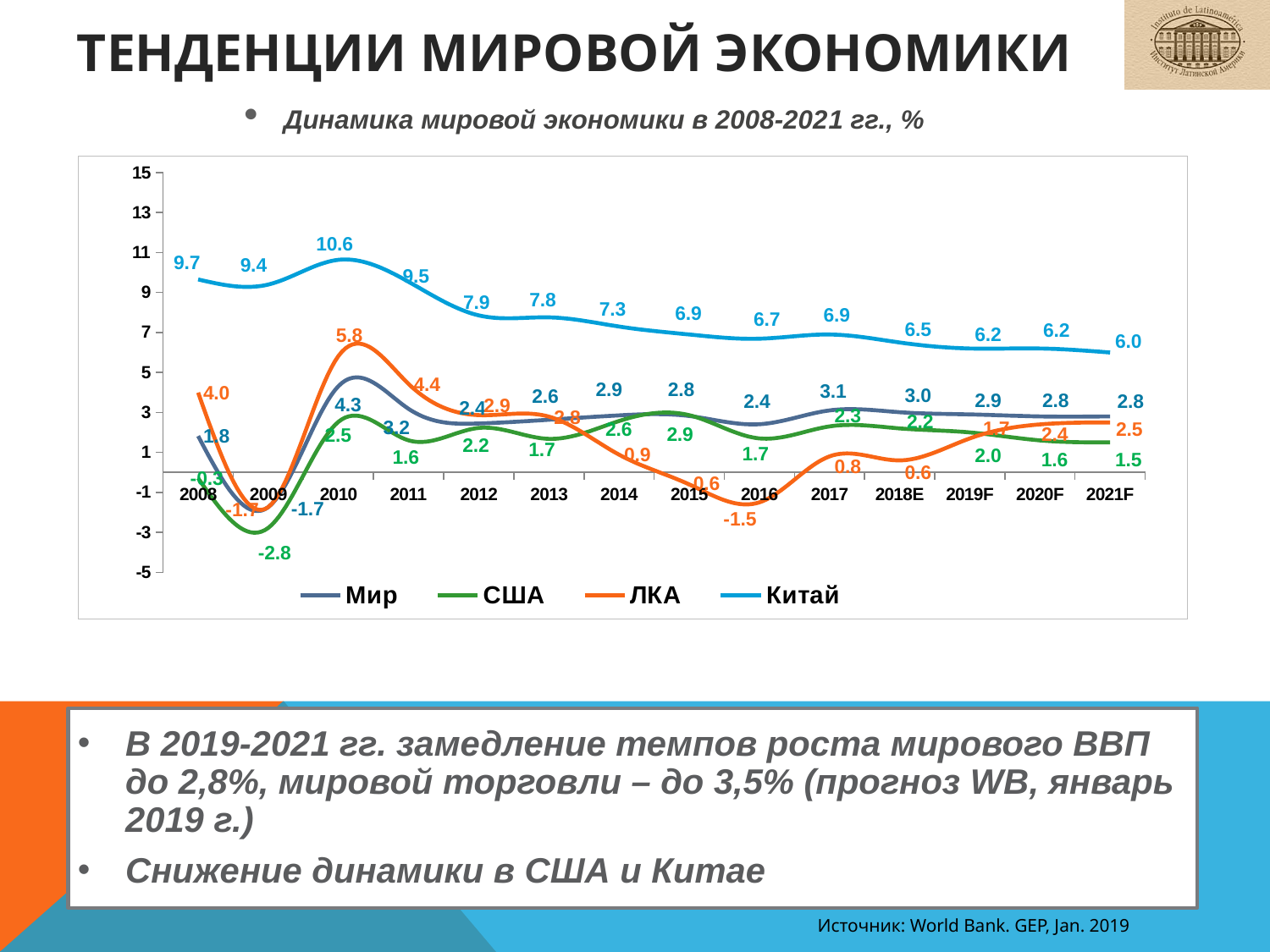
What is the difference between the Китай values in 2008 and 2021F? 3.7 How many series does the legend list? 4 What is the value for Китай in 2021F? 6.0 What kind of chart is shown on the slide? Line chart What is the value for ЛКА in 2010? 5.8 Does the Китай series rise or fall from 2010 to 2021F? Falls In which year does the США series reach its lowest value? 2009 In which year does the Китай series reach its highest value? 2010 How many years are plotted along the x axis? 14 What is the value for США in 2009? -2.8 In 2017, which series has the higher value, Мир or США? Мир What is the value for Китай in 2010? 10.6